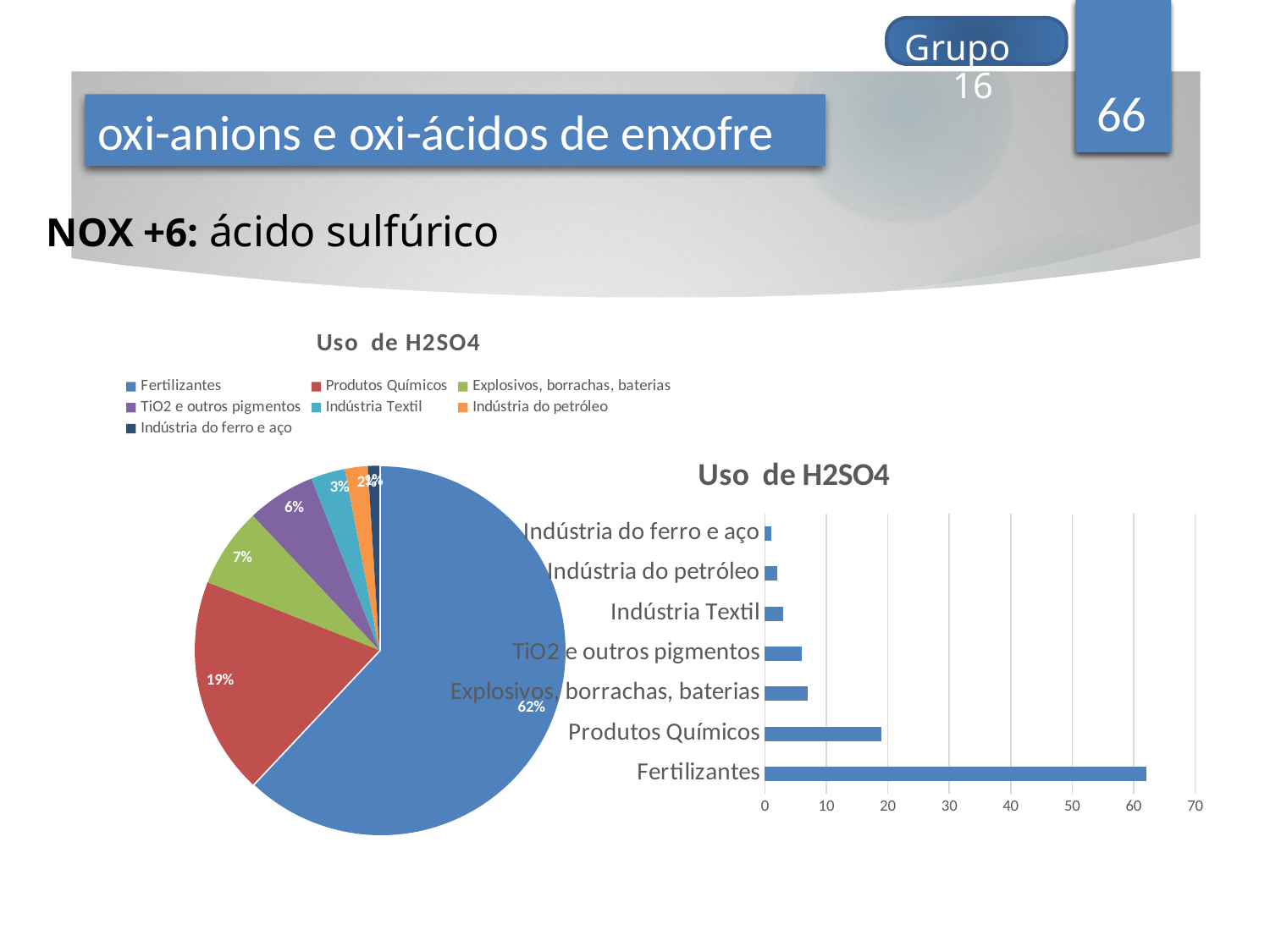
In the pie chart on the left, what share does Fertilizantes have? 62% In the pie chart on the left, what is the difference between the shares of Fertilizantes and Produtos Químicos? 43% What kind of chart is the chart on the right of the slide? bar chart In the pie chart on the left, what share does Produtos Químicos have? 19% In the bar chart on the right, is the value for Fertilizantes greater or less than 60? greater In the pie chart on the left, which category has the largest slice? Fertilizantes In the pie chart on the left, what share does Explosivos, borrachas, baterias have? 7% What kind of chart is the chart on the left of the slide? pie chart In the pie chart on the left, what share does TiO2 e outros pigmentos have? 6% In the bar chart on the right, which category has the shortest bar? Indústria do ferro e aço How many entries does the legend of the pie chart on the left list? 7 In the bar chart on the right, is the value for Produtos Químicos greater or less than 20? less